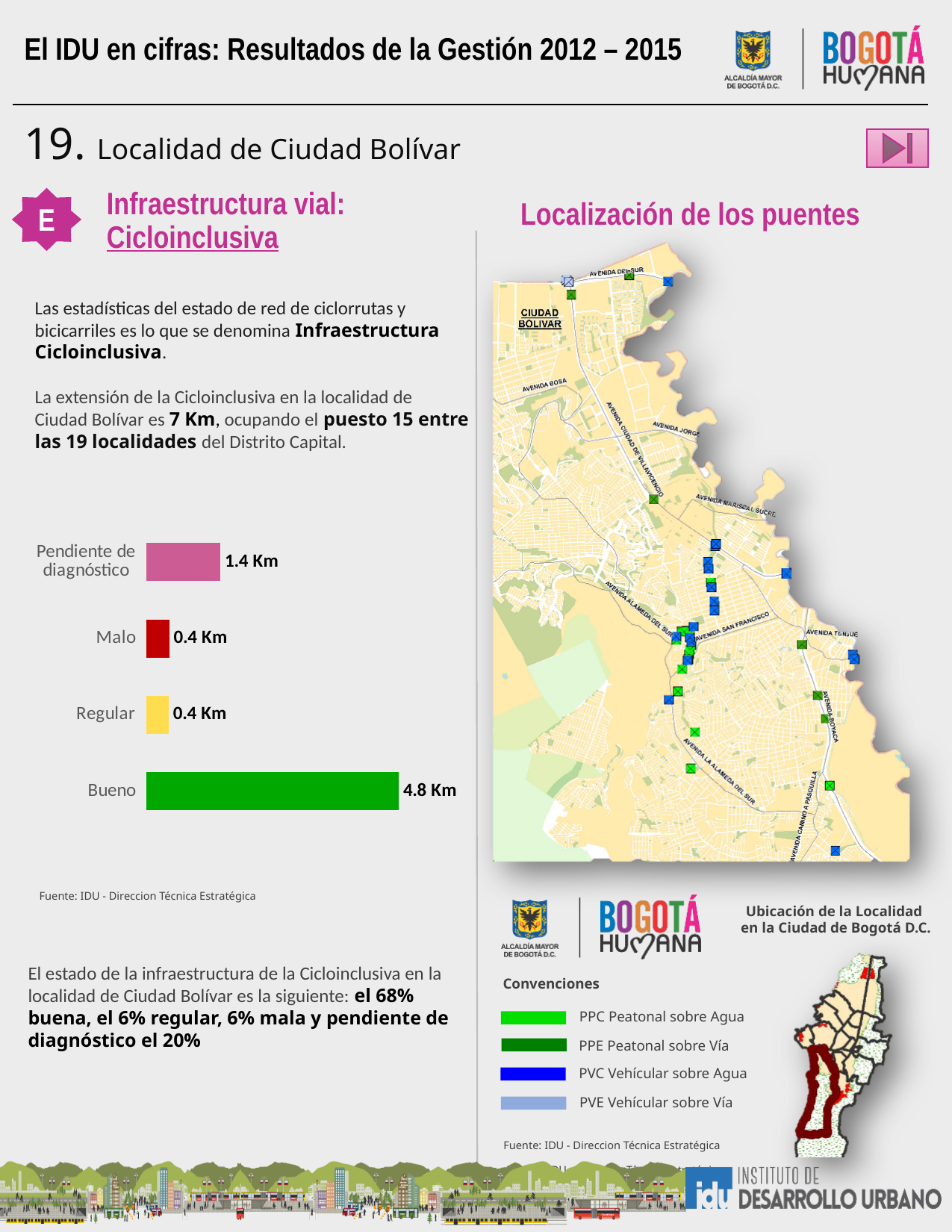
Which category has the highest value in the bar chart? Bueno Which is larger in the bar chart, the value for Bueno or the value for Pendiente de diagnóstico? Bueno What is the difference between the values for Pendiente de diagnóstico and Malo in the bar chart? 1.0 Km What is the value for Malo in the bar chart? 0.4 Km What is the difference between the values for Bueno and Pendiente de diagnóstico in the bar chart? 3.4 Km What kind of chart is used to show the state of the Cicloinclusiva infrastructure? Bar chart What is the value for Pendiente de diagnóstico in the bar chart? 1.4 Km What is the total of all four values in the bar chart? 7.0 Km What is the value for Regular in the bar chart? 0.4 Km How many categories does the bar chart show? 4 What is the value for Bueno in the bar chart? 4.8 Km What colour is the bar for Bueno in the bar chart? Green